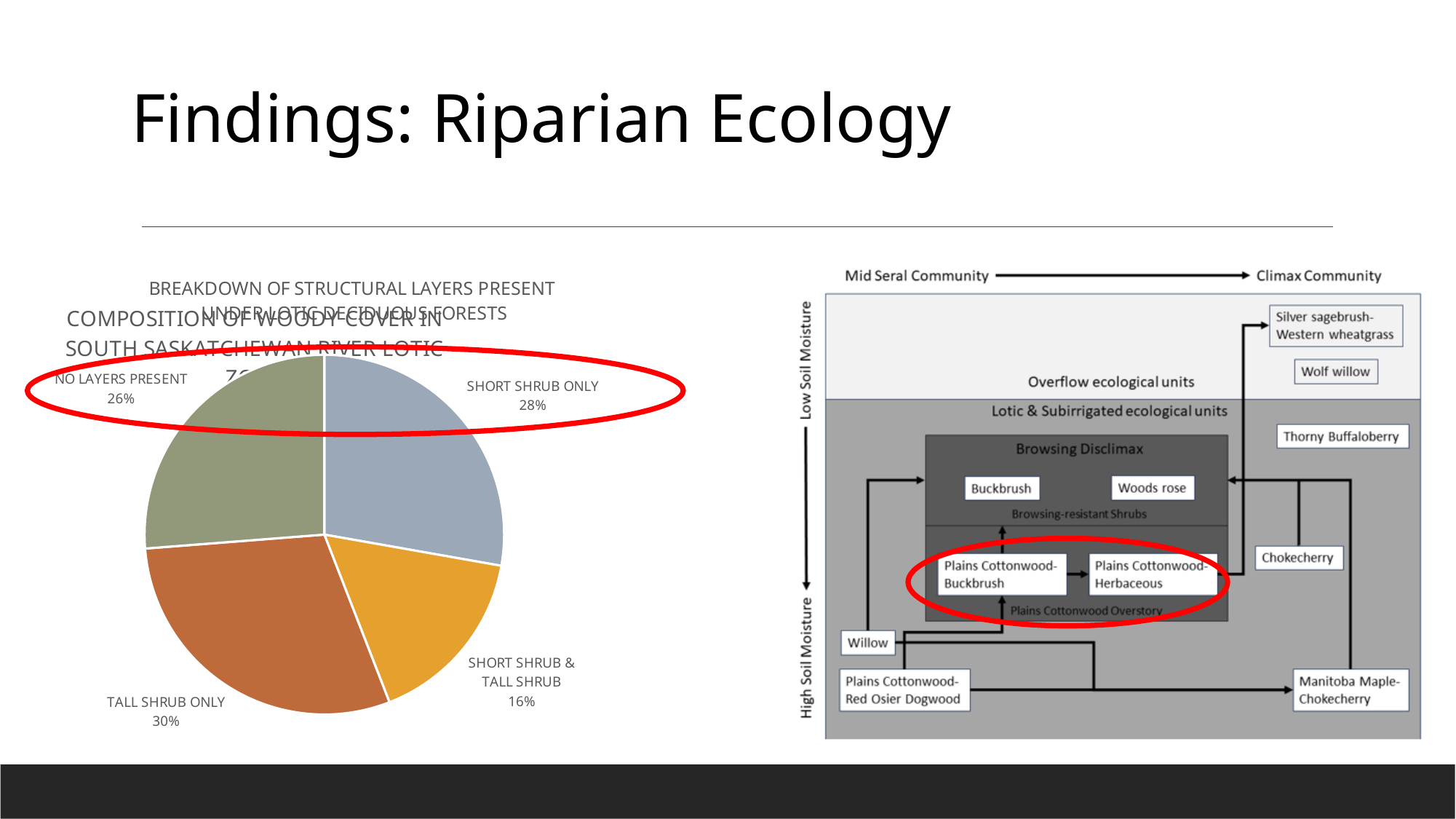
What type of chart is shown on the left of the slide? Pie chart What is the combined share of Short Shrub Only and Tall Shrub Only in the pie chart? 58% Which category has the smallest share of the pie chart? Short Shrub & Tall Shrub Which category has the largest share of the pie chart? Tall Shrub Only What percentage of the pie chart is No Layers Present? 26% What colour is the Tall Shrub Only slice of the pie chart? Brown/orange-brown What is the difference in percentage points between Tall Shrub Only and Short Shrub & Tall Shrub? 14 What percentage of the pie chart is Short Shrub & Tall Shrub? 16% Which is larger in the pie chart: Short Shrub Only or No Layers Present? Short Shrub Only What percentage of the pie chart is Short Shrub Only? 28% What percentage of the pie chart is Tall Shrub Only? 30% How many slices does the pie chart have? 4